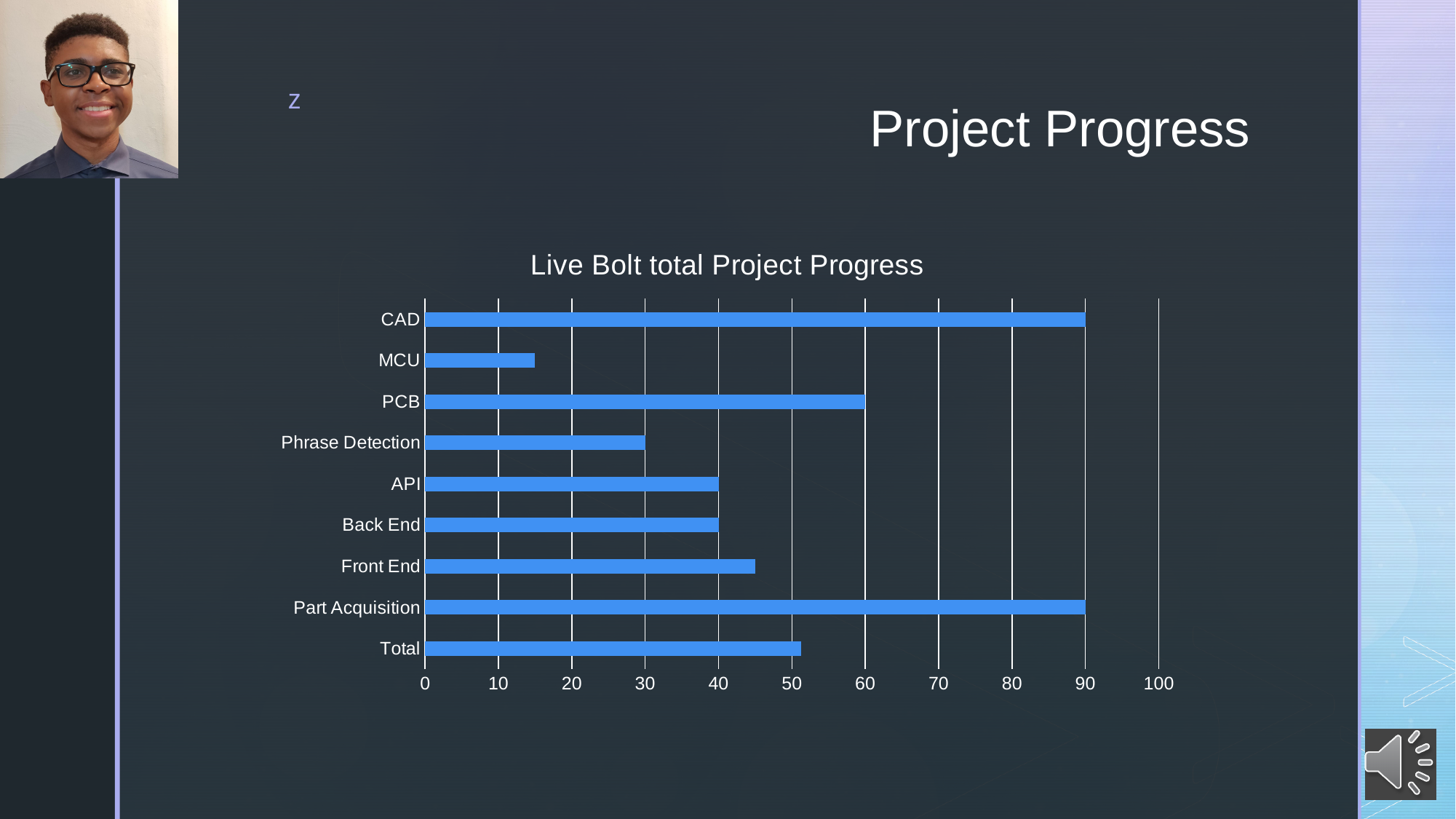
Which category has the lowest value? MCU What is the value for CAD? 90 What is the value for Phrase Detection? 30 Which is larger, the value for PCB or the value for Phrase Detection? PCB Is the value for Front End greater or less than 40? greater What is the value for Back End? 40 What type of chart is shown on the slide? bar chart Is the value for MCU greater or less than 20? less How many categories are plotted in the chart? 9 What is the title of the chart? Live Bolt total Project Progress What is the difference between the values for CAD and PCB? 30 What is the value for PCB? 60